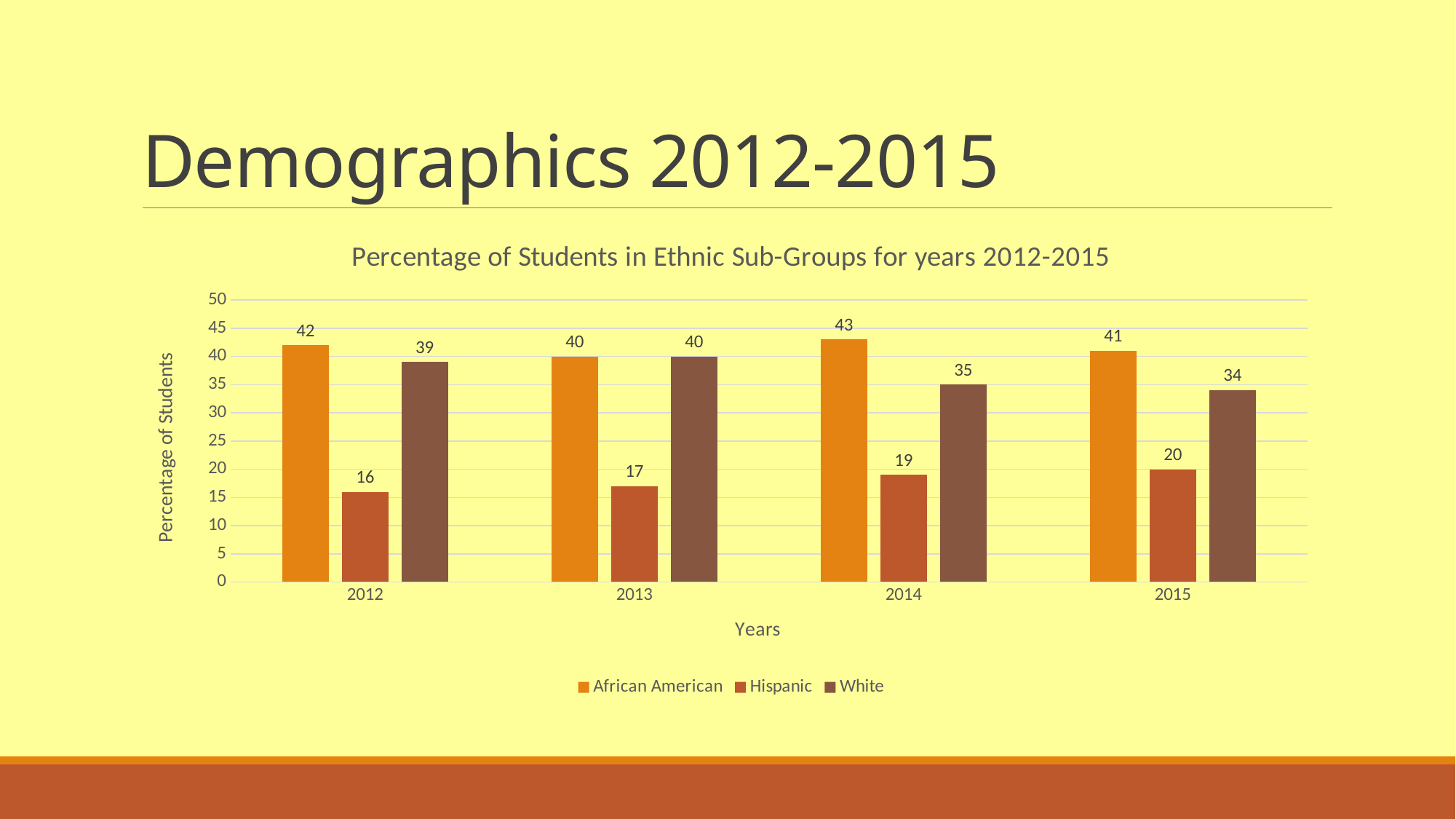
In which year is the Hispanic value highest? 2015 What is the value for Hispanic in 2012? 16 Which is larger in 2012, the African American value or the White value? African American What is the title of the chart? Percentage of Students in Ethnic Sub-Groups for years 2012-2015 What is the value for African American in 2014? 43 How many series does the legend list? 3 How many years are shown on the x axis? 4 What is the value for White in 2015? 34 What is the difference between the African American and Hispanic values in 2013? 23 What kind of chart is shown on the slide? Bar chart Do the Hispanic values rise or fall from 2012 to 2015? Rise In which year is the White value lowest? 2015